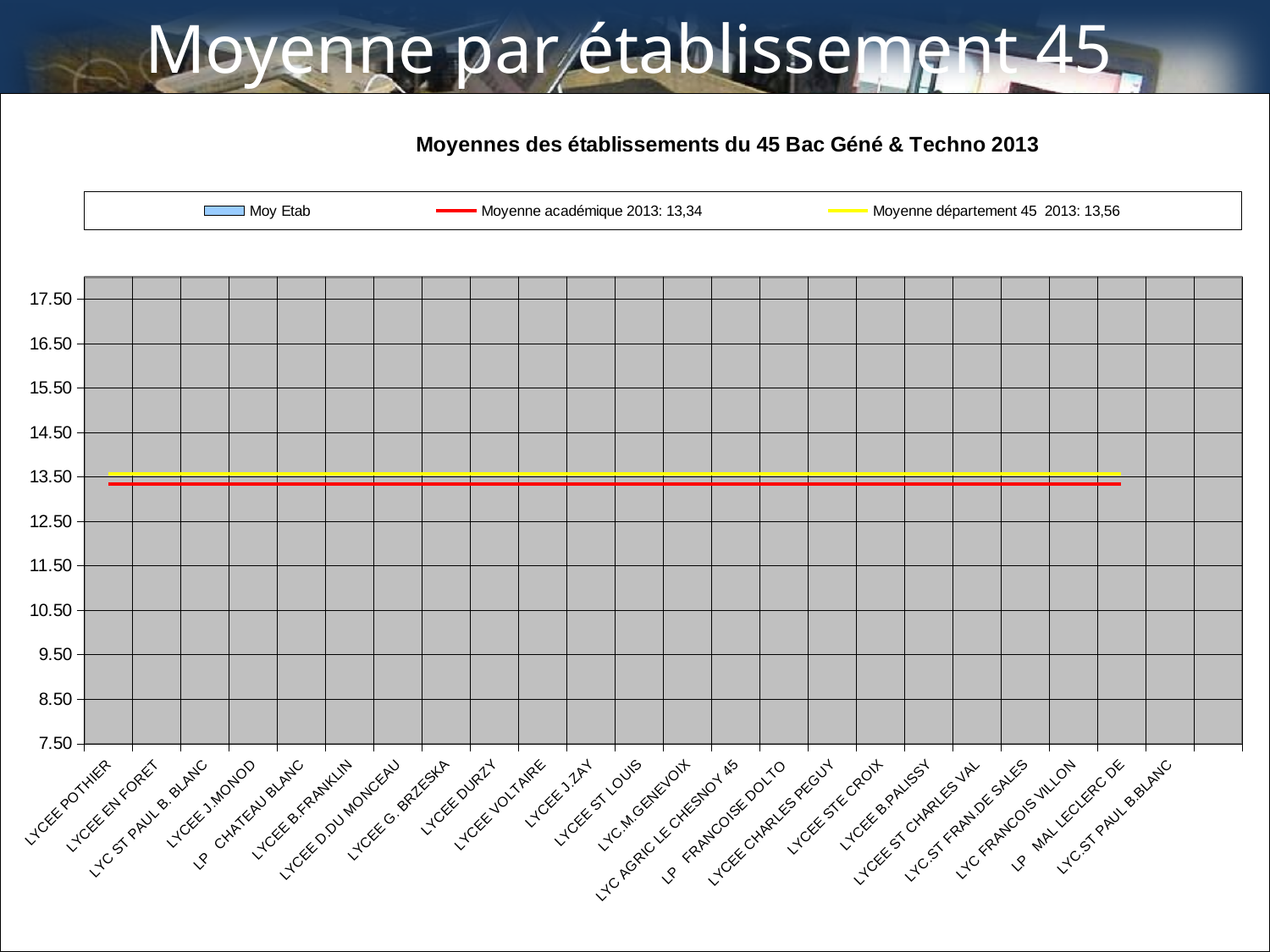
Is the Moyenne département 45 2013 line greater or less than 14.50? less How many series does the legend list? 3 What is the title of the chart? Moyennes des établissements du 45 Bac Géné & Techno 2013 What colour is the line for the Moyenne académique 2013? Red What is the value of the Moyenne académique 2013 shown in the legend? 13,34 Is the Moyenne académique 2013 line greater or less than 12.50? greater Which is larger, the Moyenne académique 2013 or the Moyenne département 45 2013? Moyenne département 45 2013 What is the difference between the Moyenne département 45 2013 and the Moyenne académique 2013? 0,22 How many establishments are listed along the x axis? 23 What is the lowest value shown on the y axis? 7.50 What is the value of the Moyenne département 45 2013 shown in the legend? 13,56